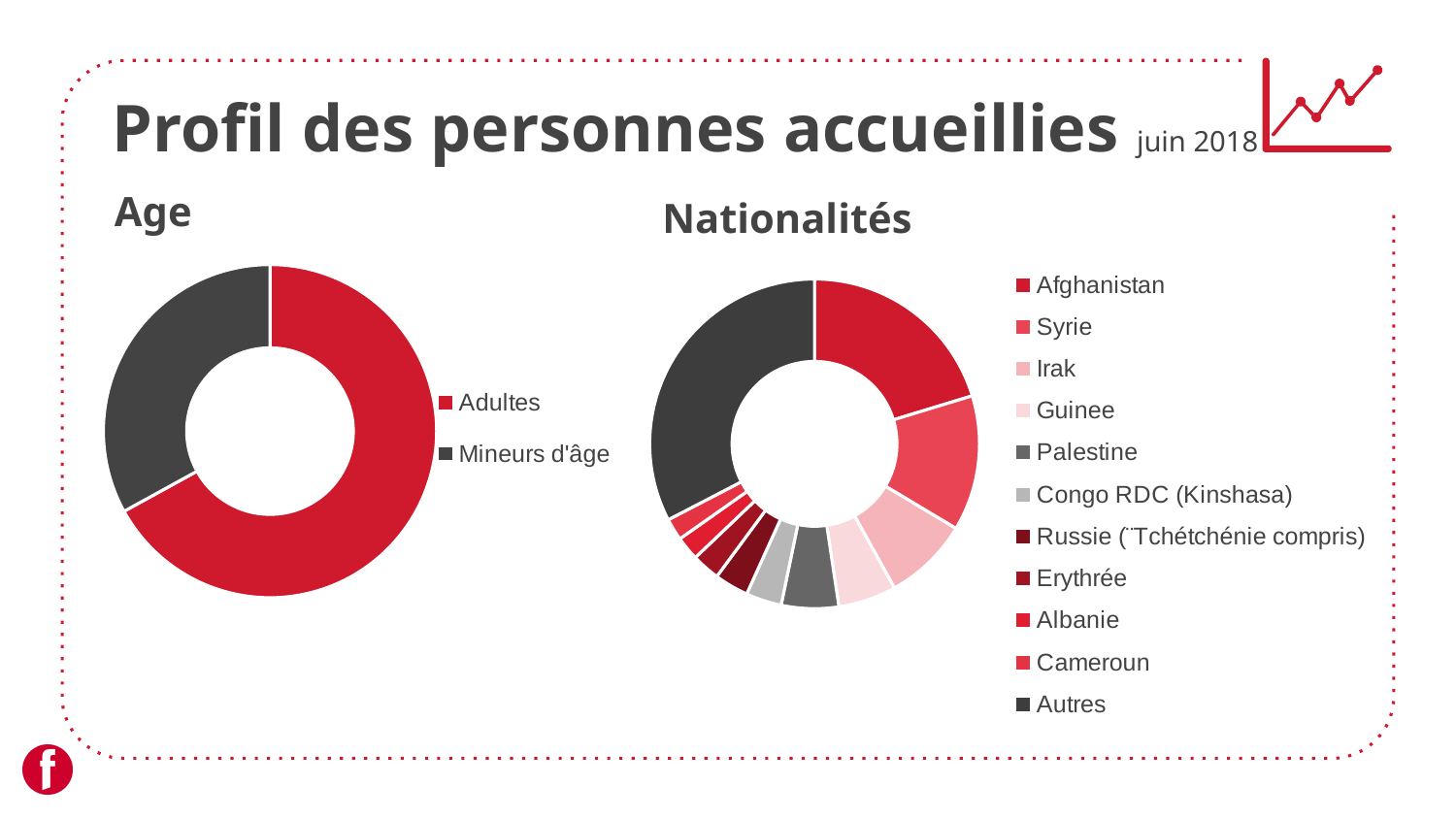
In the Nationalités chart, which is larger: Irak or Guinee? Irak How many categories does the legend of the Nationalités chart list? 11 What kind of chart is the Age chart? doughnut chart In the Age chart, which category has the smallest share? Mineurs d'âge In the Age chart, which category has the largest share? Adultes How many categories does the legend of the Age chart list? 2 What is the title of the slide containing the two charts? Profil des personnes accueillies In the Age chart, which is larger: Adultes or Mineurs d'âge? Adultes What kind of chart is the Nationalités chart? doughnut chart In the Age chart, what colour is the Mineurs d'âge segment? dark grey In the Nationalités chart, which is larger: Afghanistan or Syrie? Afghanistan